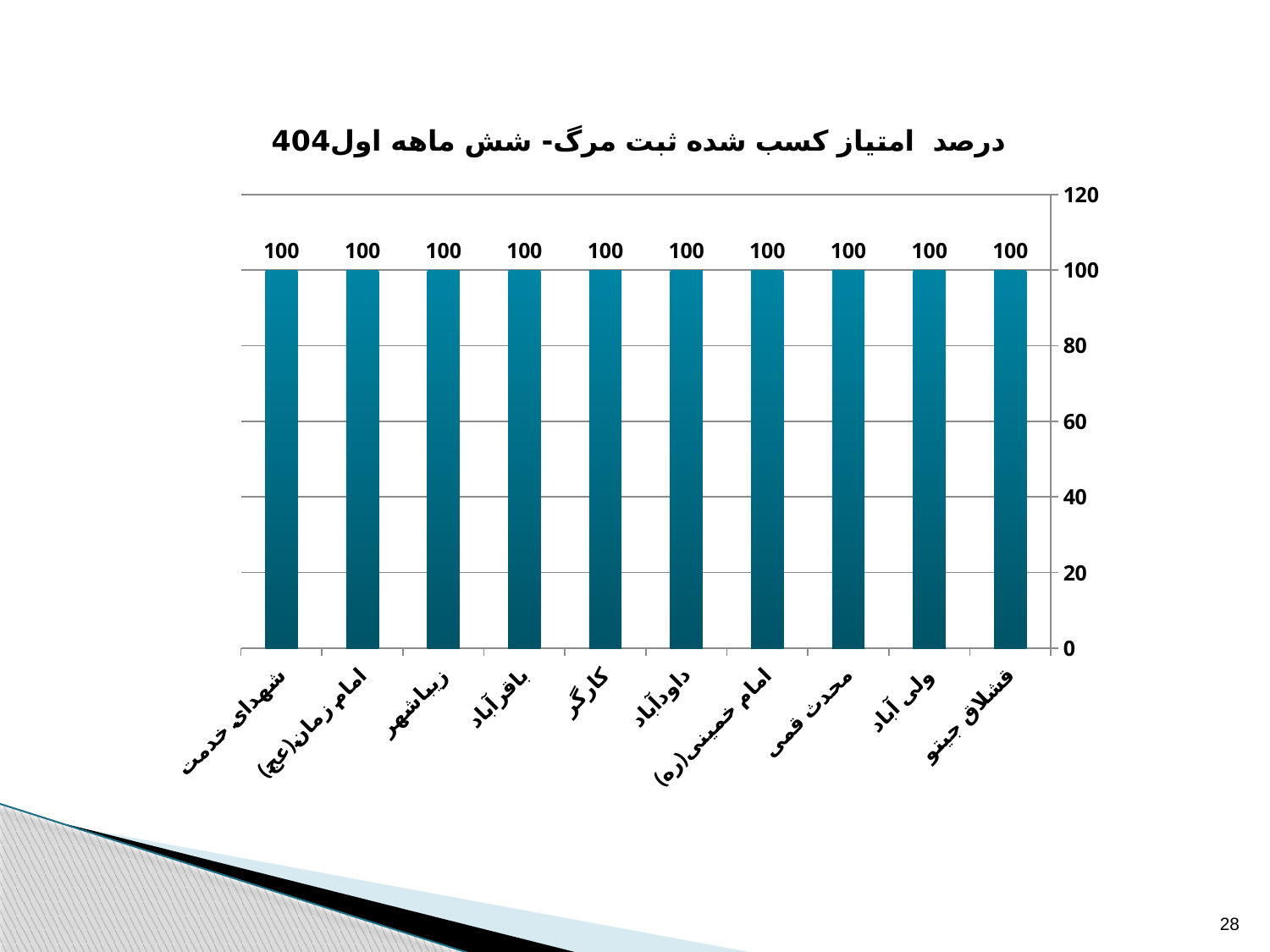
What is the value for کارگر? 100 What is the value for شهدای خدمت? 100 What is the title of the chart? درصد امتیاز کسب شده ثبت مرگ- شش ماهه اول404 What is the highest value shown on the vertical axis? 120 What kind of chart is shown on the slide? bar chart How many categories are shown on the x axis? 10 What is the value for امام خمینی(ره)? 100 Is the value for باقرآباد greater or less than 80? greater What is the value for قشلاق جیتو? 100 What is the value for محدث قمی? 100 Do the values rise, fall, or stay the same across the categories along the x axis? stay the same What is the difference between the values for زیباشهر and ولی آباد? 0